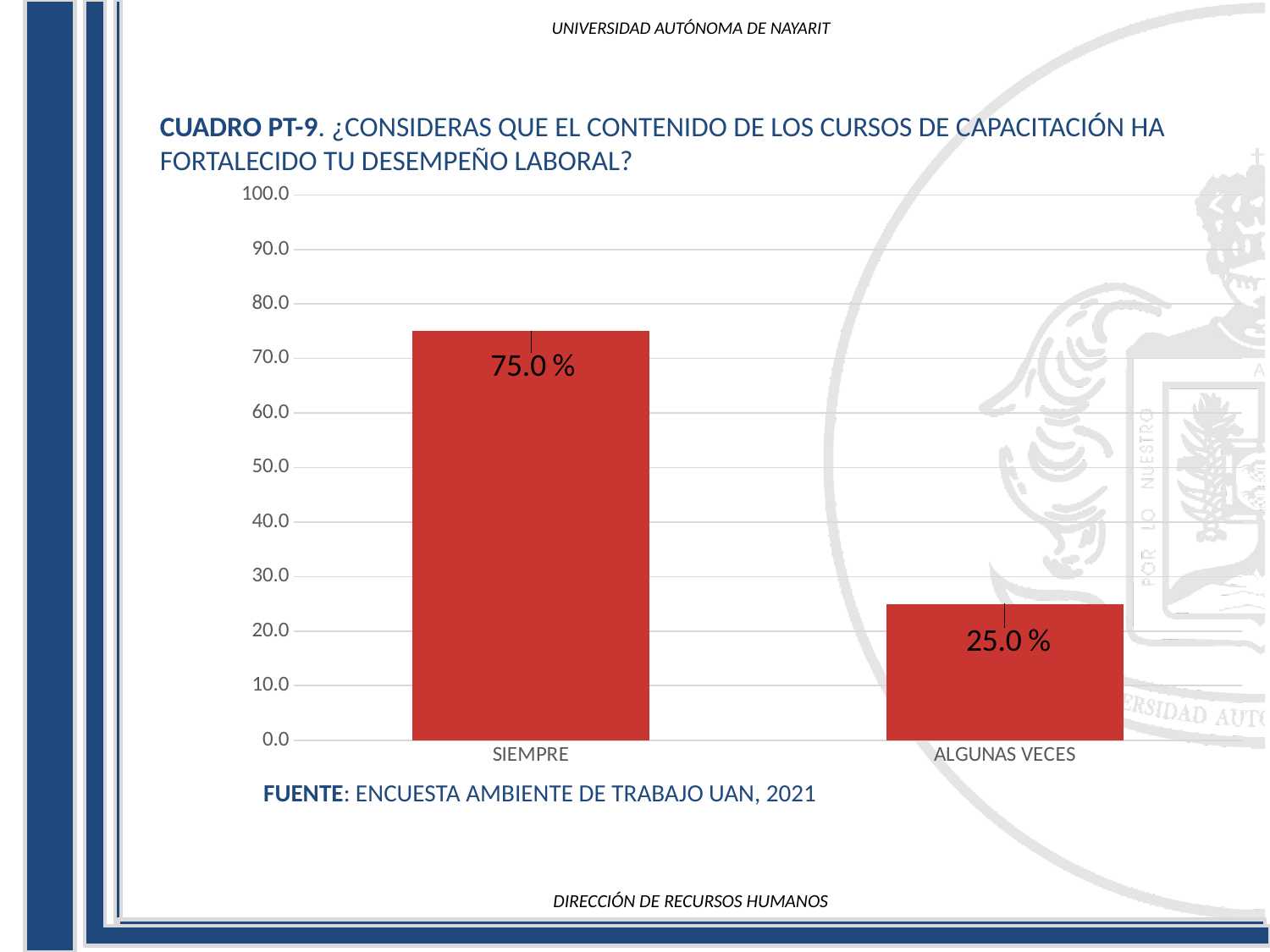
Is the value for SIEMPRE greater or less than 70.0? greater What is the difference between the values for SIEMPRE and ALGUNAS VECES? 50.0 % What is the value for SIEMPRE? 75.0 % How many categories are shown on the x axis? 2 What kind of chart is shown on the slide? Bar chart What is the value for ALGUNAS VECES? 25.0 % Which category has the highest value? SIEMPRE Which is larger, the value for SIEMPRE or the value for ALGUNAS VECES? SIEMPRE What source is cited below the chart? ENCUESTA AMBIENTE DE TRABAJO UAN, 2021 Which category has the lowest value? ALGUNAS VECES Is the value for ALGUNAS VECES greater or less than 30.0? less Do the values rise or fall from SIEMPRE to ALGUNAS VECES? Fall